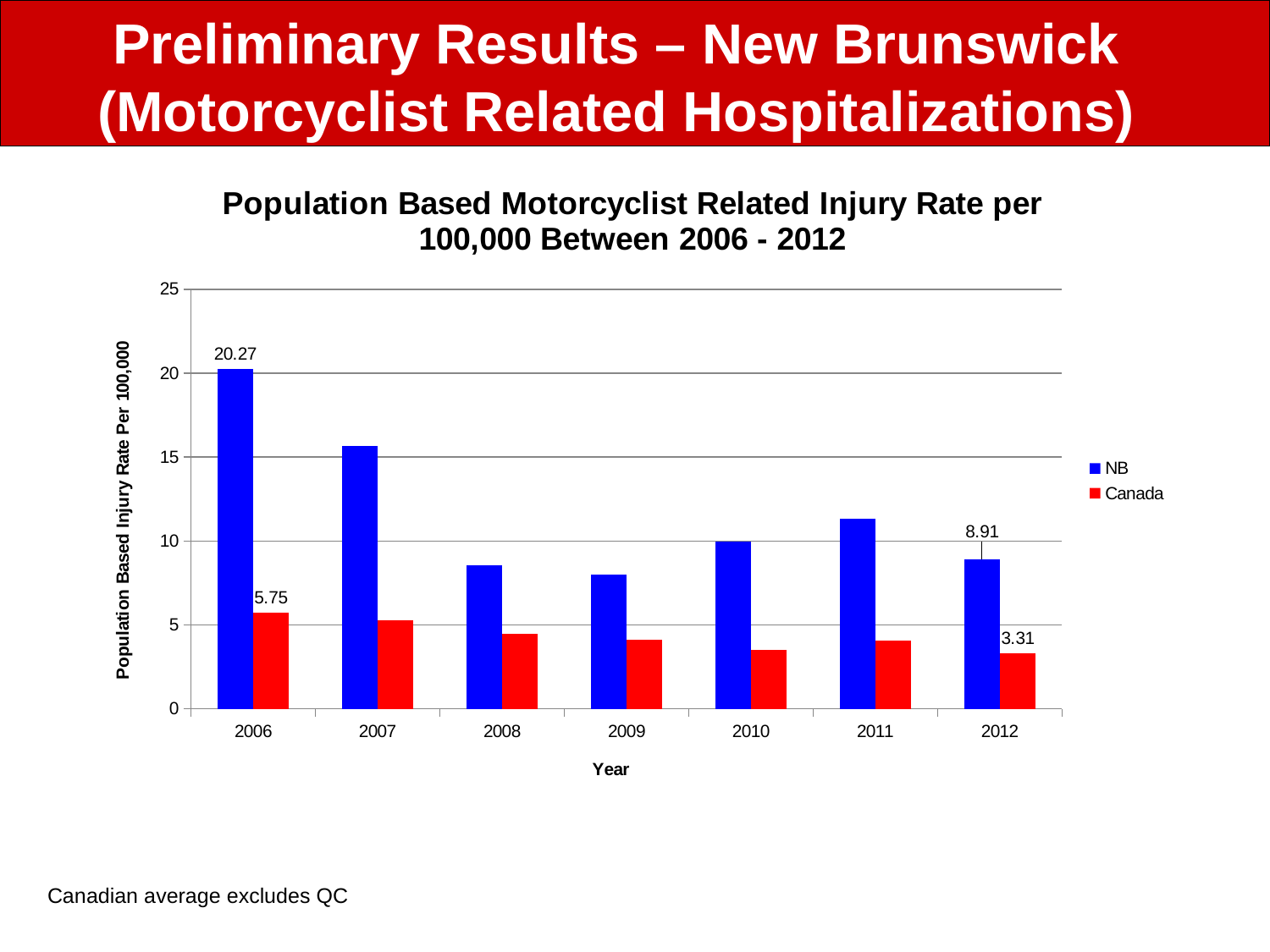
Is the NB injury rate for 2009 greater or less than 10? less What is the Canada injury rate per 100,000 in 2012? 3.31 How many years are shown on the x axis? 7 What kind of chart is shown on the slide? Bar chart How many series does the legend list? 2 In which year was the NB injury rate highest? 2006 By how much did the NB injury rate fall from 2006 to 2012? 11.36 What is the Canada injury rate per 100,000 in 2006? 5.75 What is the NB injury rate per 100,000 in 2006? 20.27 What is the NB injury rate per 100,000 in 2012? 8.91 What is the difference between the NB and Canada injury rates in 2006? 14.52 Is the NB injury rate for 2011 greater or less than 10? greater